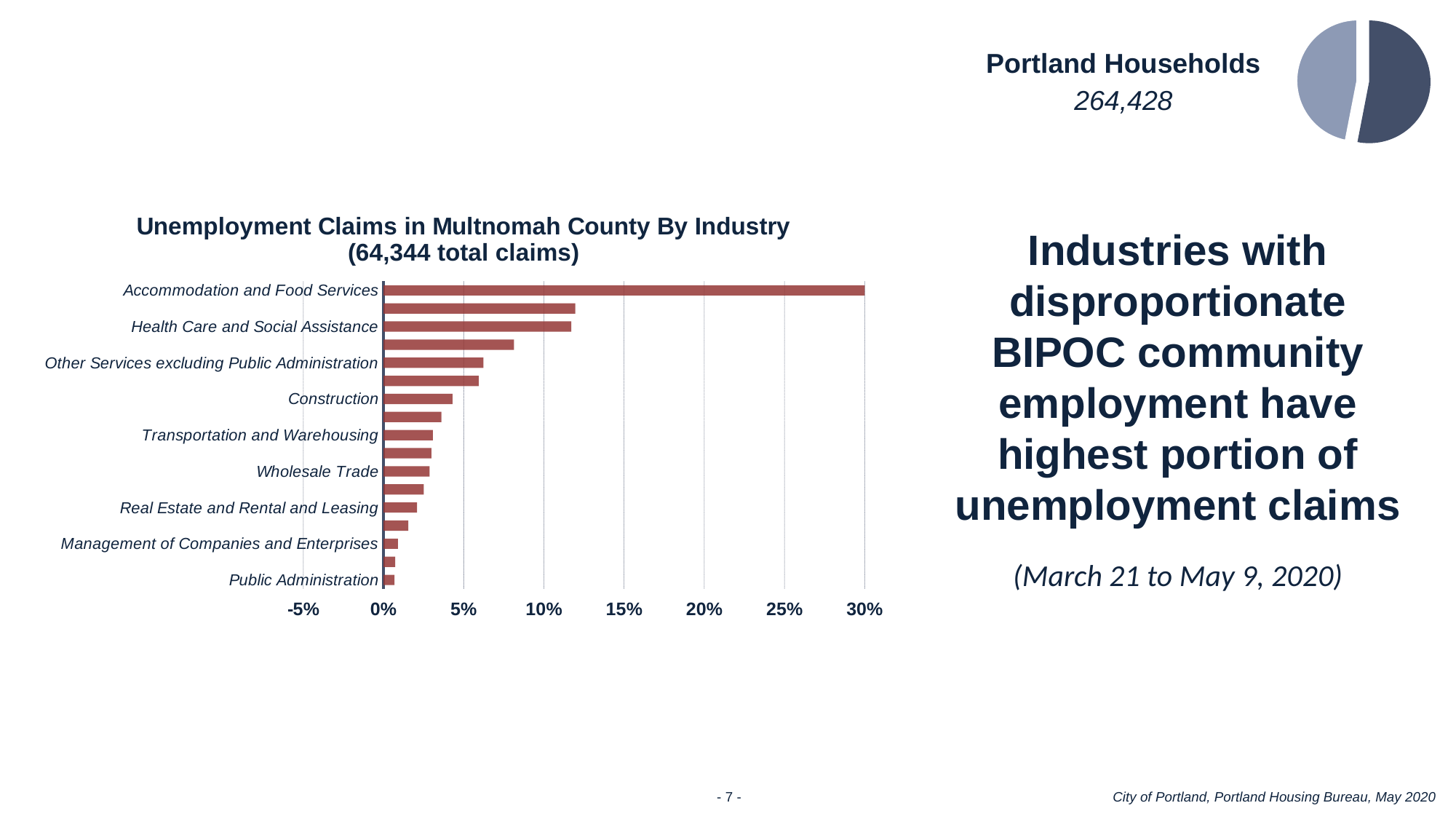
How many bars are plotted in the chart? 17 Which has a larger share of unemployment claims, Health Care and Social Assistance or Construction? Health Care and Social Assistance Is the value for Construction greater or less than 5%? less What kind of chart is shown on the slide? Bar chart Is the value for Other Services excluding Public Administration greater or less than 5%? greater According to the chart title, how many total unemployment claims are represented? 64,344 Is the value for Accommodation and Food Services greater or less than 25%? greater Of the industries labeled on the axis, which has the lowest share of unemployment claims? Public Administration Which industry has the highest share of unemployment claims in the chart? Accommodation and Food Services Which has a larger share of unemployment claims, Wholesale Trade or Accommodation and Food Services? Accommodation and Food Services